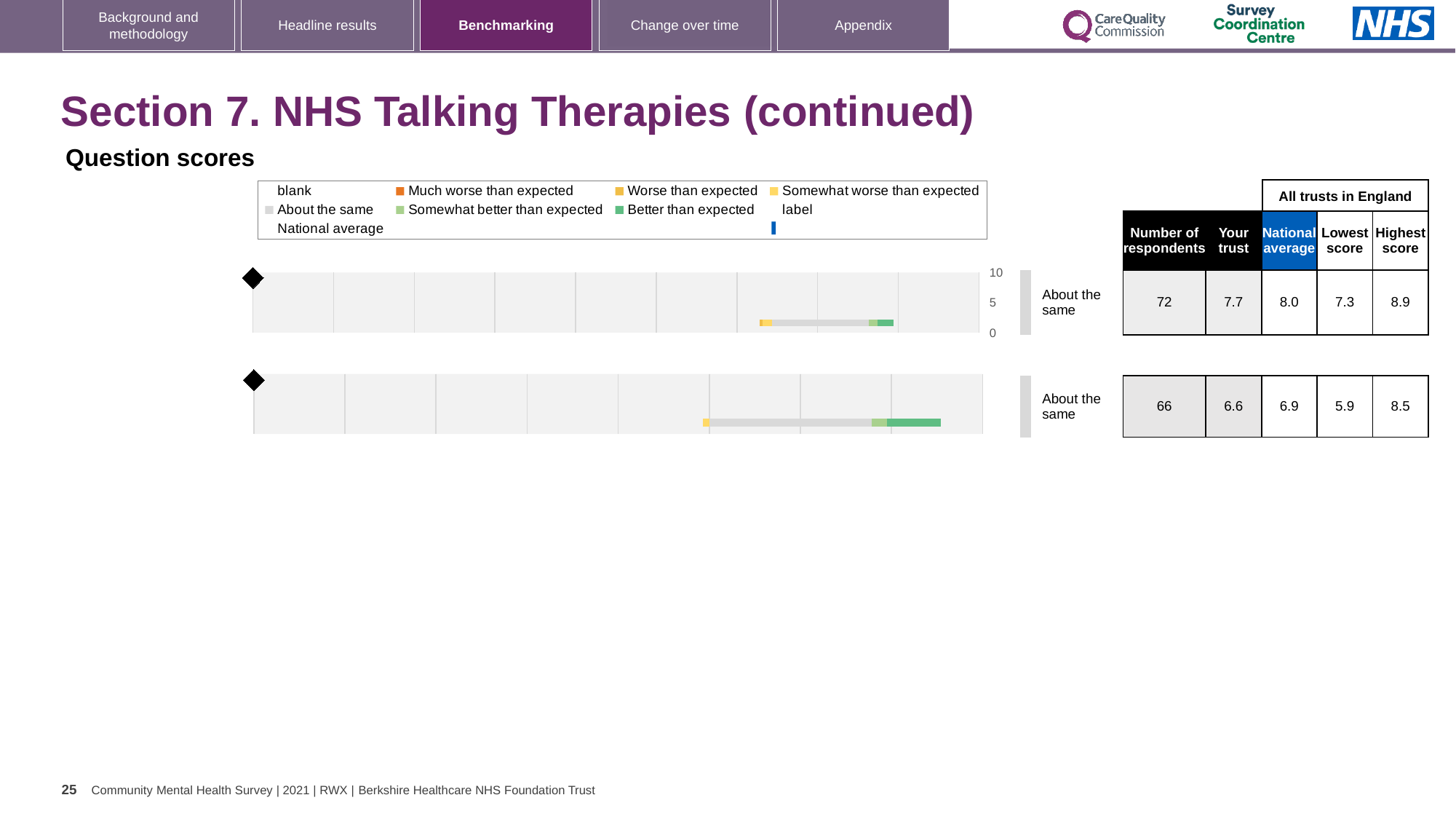
How many question score charts (rows) are shown on the slide? 2 For the top chart, what is the difference between the highest score and the lowest score among all trusts in England? 1.6 What is the maximum value shown on the score axis of the charts? 10 For the top chart, what is the 'Your trust' score? 7.7 For the top chart, which is larger: the 'Your trust' score or the national average? National average For the bottom chart, how many respondents are there? 66 For the top chart, what is the national average score? 8.0 What benchmark category label is shown next to both charts? About the same For the bottom chart, which is larger: the 'Your trust' score or the national average? National average For the bottom chart, what is the difference between the highest score and the lowest score among all trusts in England? 2.6 What kind of chart is used to show the question scores on this slide? bar chart For the bottom chart, what is the lowest score among all trusts in England? 5.9